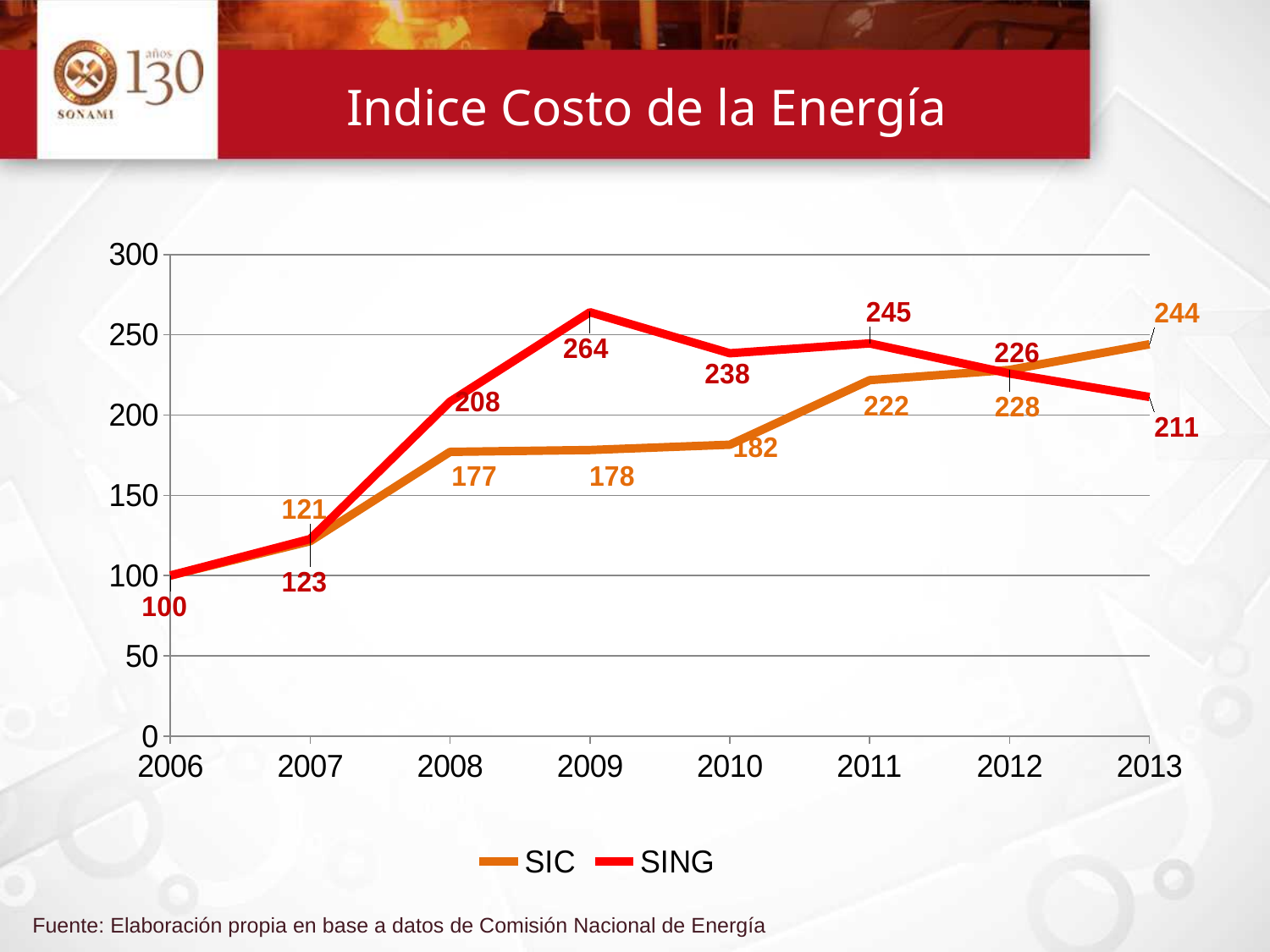
What is the difference between the SIC and SING values in 2013? 33 How many years are shown on the x axis? 8 In 2011, which series has the higher value, SIC or SING? SING What kind of chart is shown on the slide? line chart Is the value for SIC in 2010 greater or less than 200? less What is the value of the SING series in 2009? 264 In which year does the SIC series reach its highest value? 2013 What is the value of the SIC series in 2013? 244 What is the value of the SIC series in 2011? 222 What is the difference between the SING values in 2009 and 2010? 26 How many series does the legend list? 2 In which year does the SING series reach its highest value? 2009